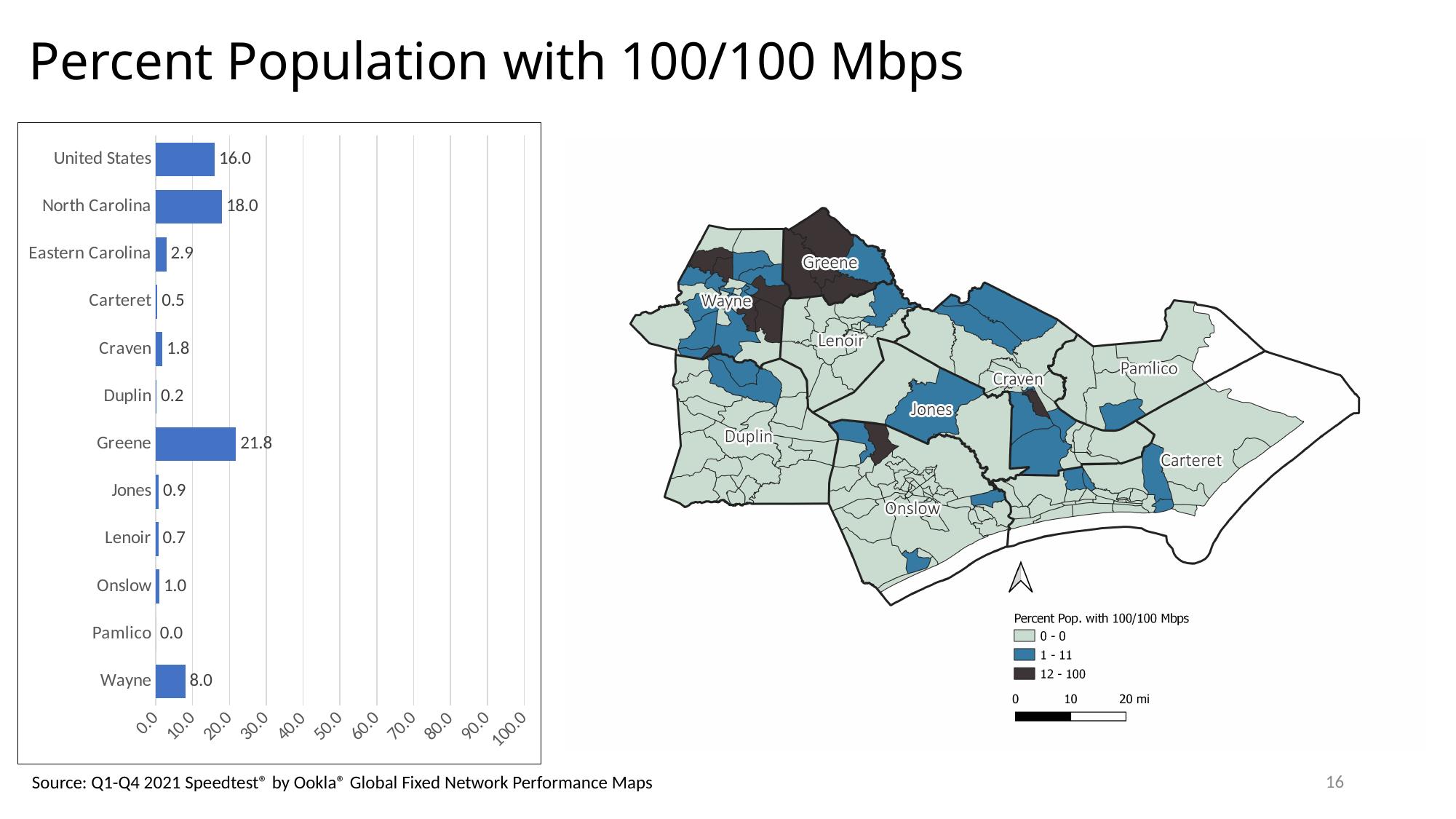
What is the value for Greene in the bar chart? 21.8 What is the value for Wayne in the bar chart? 8.0 What is the maximum value shown on the x axis of the bar chart? 100.0 How many categories are shown in the bar chart? 12 Which category has the lowest value in the bar chart? Pamlico What is the value for Eastern Carolina in the bar chart? 2.9 What kind of chart is shown on the left of the slide? Bar chart What is the difference between the values for North Carolina and United States in the bar chart? 2.0 What is the difference between the values for Greene and Wayne in the bar chart? 13.8 Which category has the highest value in the bar chart? Greene Which is larger in the bar chart, the value for Craven or the value for Onslow? Craven What is the value for North Carolina in the bar chart? 18.0